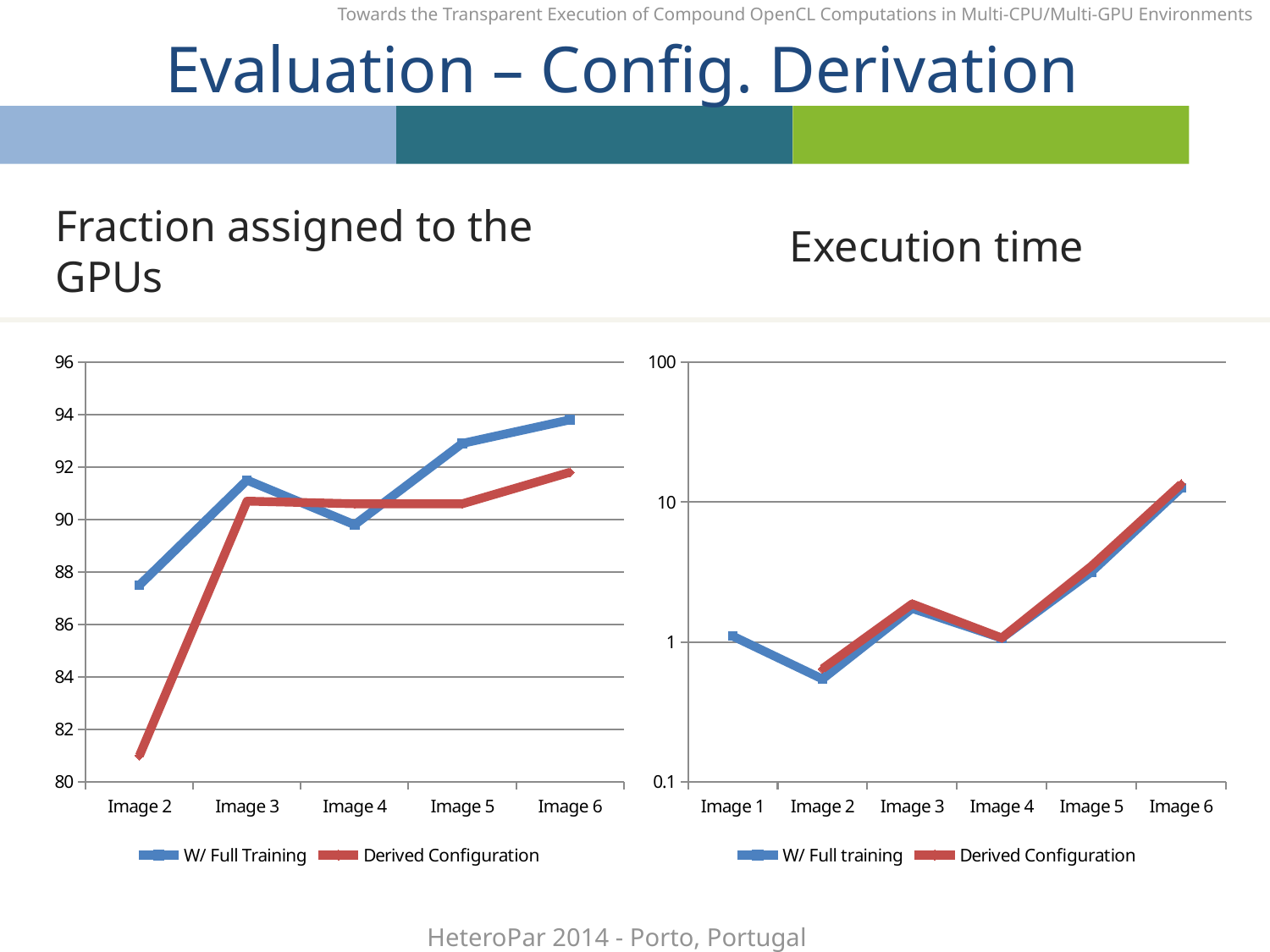
What type of chart is the 'Fraction assigned to the GPUs' chart on the left? line chart In the 'Fraction assigned to the GPUs' chart, is the W/ Full Training value for Image 6 greater or less than 92? greater How many series does the legend of the 'Execution time' chart list? 2 In the 'Execution time' chart, do the values rise or fall from Image 4 to Image 6? rise In the 'Fraction assigned to the GPUs' chart, at which image is the Derived Configuration value lowest? Image 2 In the 'Execution time' chart, is the W/ Full training value for Image 2 greater or less than 1? less How many image categories are shown on the x axis of the 'Fraction assigned to the GPUs' chart? 5 In the 'Fraction assigned to the GPUs' chart, which series has the larger value at Image 2, W/ Full Training or Derived Configuration? W/ Full Training In the 'Fraction assigned to the GPUs' chart, at which image is the W/ Full Training value highest? Image 6 In the 'Execution time' chart, at which image is the Derived Configuration execution time highest? Image 6 In the 'Fraction assigned to the GPUs' chart, is the Derived Configuration value for Image 2 greater or less than 84? less How many image categories are shown on the x axis of the 'Execution time' chart? 6